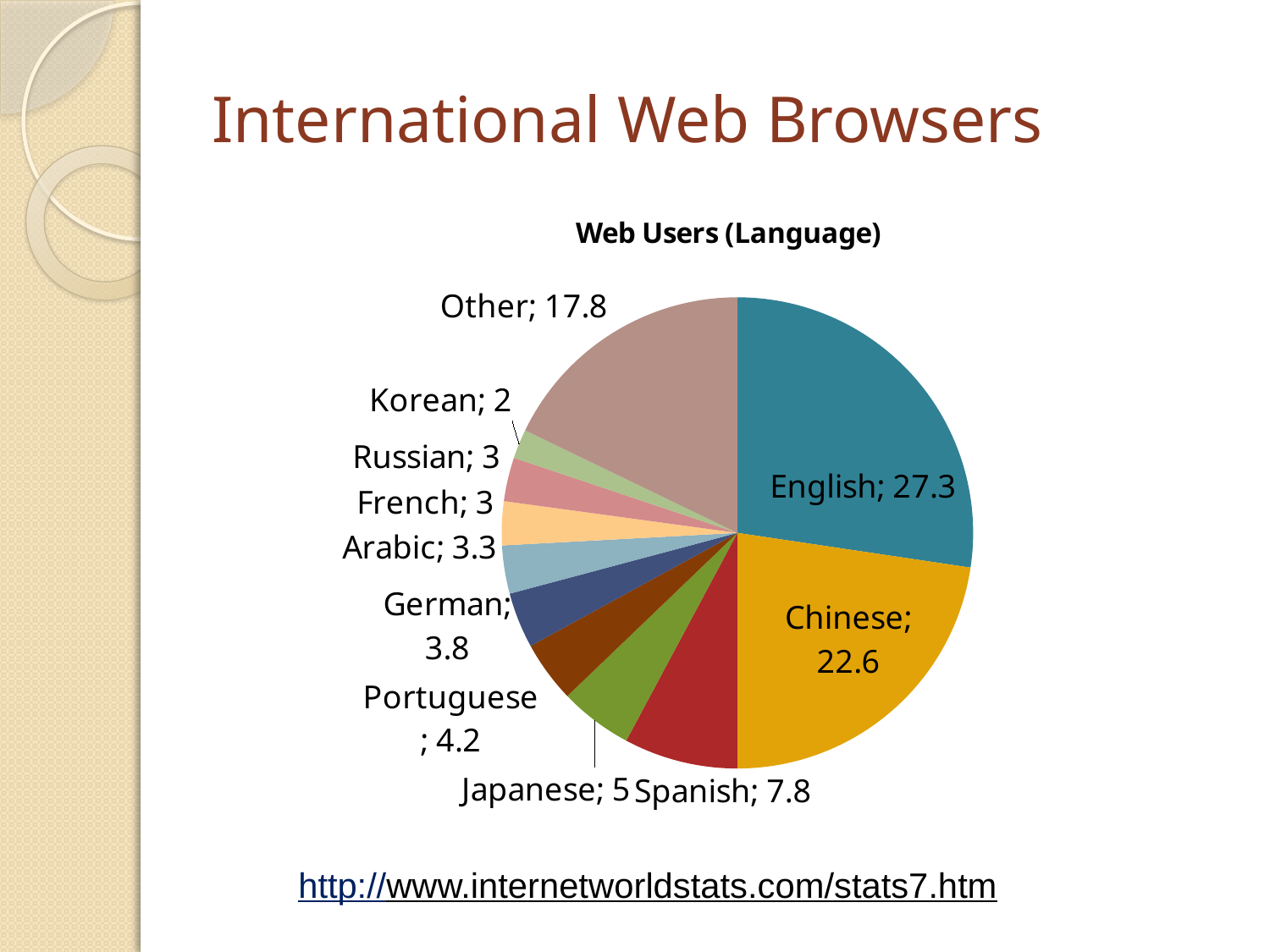
What value is shown for English in the Web Users (Language) chart? 27.3 What is the title of the chart? Web Users (Language) What value is shown for Arabic? 3.3 What type of chart is shown on the slide? pie chart Which language has the smallest slice of the pie? Korean What is the difference between the values for English and Chinese? 4.7 What value is shown for Portuguese? 4.2 What is the difference between the values for German and Korean? 1.8 What value is shown for Chinese? 22.6 How many slices (categories) does the pie chart have? 11 Which language has the largest slice of the pie? English Which is larger, the value for Spanish or the value for Japanese? Spanish